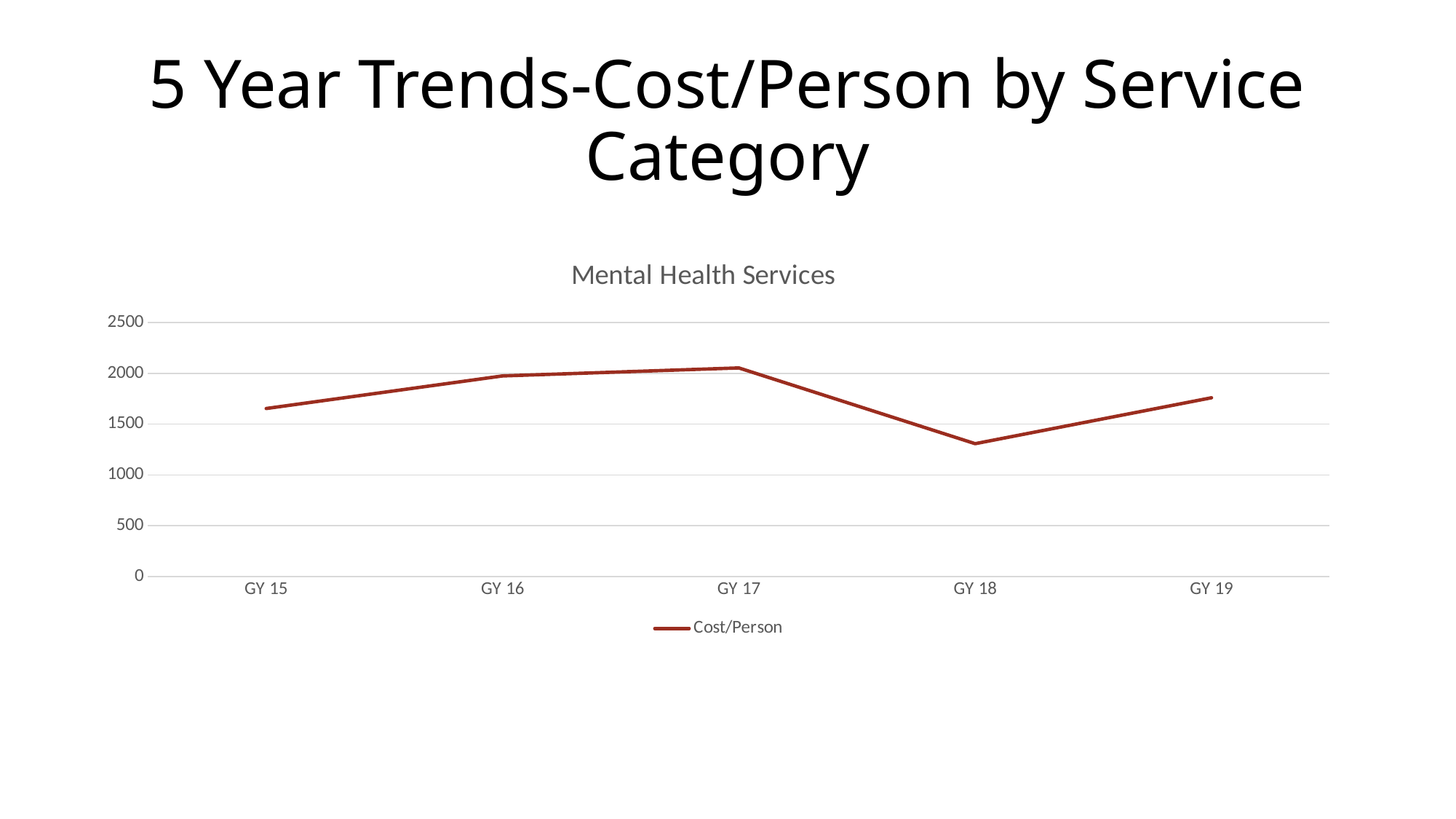
Which is larger, the Cost/Person for GY 17 or for GY 19? GY 17 Does the Cost/Person rise or fall from GY 17 to GY 18? fall How many series does the legend list? 1 What is the title of the chart? Mental Health Services Which year has the lowest Cost/Person? GY 18 Is the Cost/Person for GY 19 greater or less than 2000? less Is the Cost/Person for GY 18 greater or less than 1500? less What kind of chart is shown on the slide? line chart Which year has the highest Cost/Person? GY 17 Which is larger, the Cost/Person for GY 15 or for GY 18? GY 15 Is the Cost/Person for GY 15 greater or less than 1500? greater How many points (years) are plotted on the x axis of the chart? 5